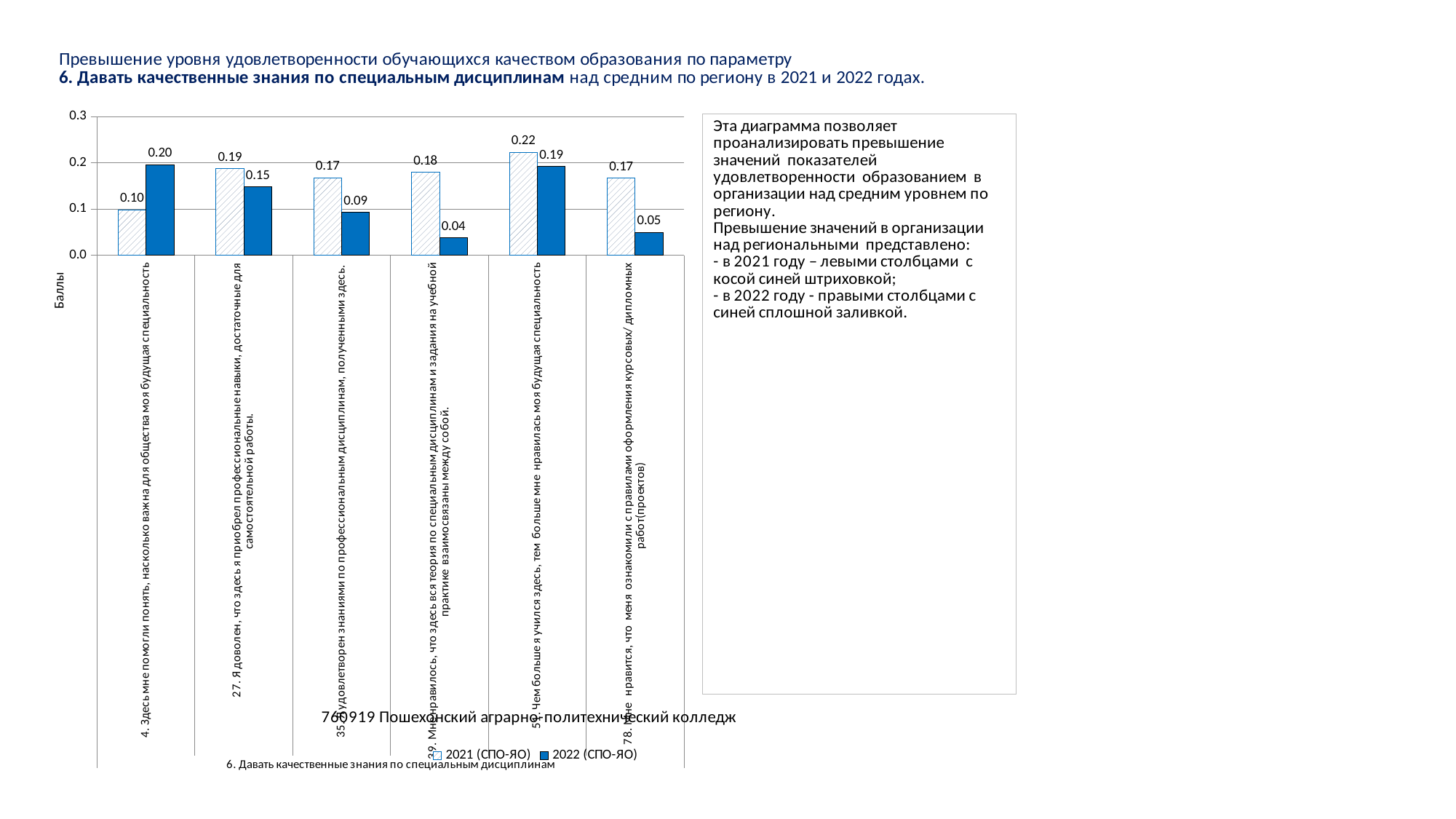
What type of chart is shown on the slide? bar chart How many series does the chart legend list? 2 Which statement has the lowest 2022 (СПО-ЯО) value? 39. Мне нравилось, что здесь вся теория по специальным дисциплинам и задания на учебной практике взаимосвязаны между собой For statement 27 ("Я доволен, что здесь я приобрел профессиональные навыки, достаточные для самостоятельной работы"), which is larger: the 2021 value or the 2022 value? 2021 What is the difference between the 2021 and 2022 values for statement 35 ("Я удовлетворен знаниями по профессиональным дисциплинам, полученными здесь")? 0.08 What is the 2022 (СПО-ЯО) value for statement 78 ("Мне нравится, что меня ознакомили с правилами оформления курсовых/дипломных работ")? 0.05 Which statement has the highest 2021 (СПО-ЯО) value? 51. Чем больше я учился здесь, тем больше мне нравилась моя будущая специальность What is the label of the vertical axis of the chart? Баллы What is the 2022 (СПО-ЯО) value for statement 4 ("Здесь мне помогли понять, насколько важна для общества моя будущая специальность")? 0.20 How many categories (statements) are plotted on the chart? 6 What is the 2021 (СПО-ЯО) value for statement 39 ("Мне нравилось, что здесь вся теория по специальным дисциплинам и задания на учебной практике взаимосвязаны между собой")? 0.18